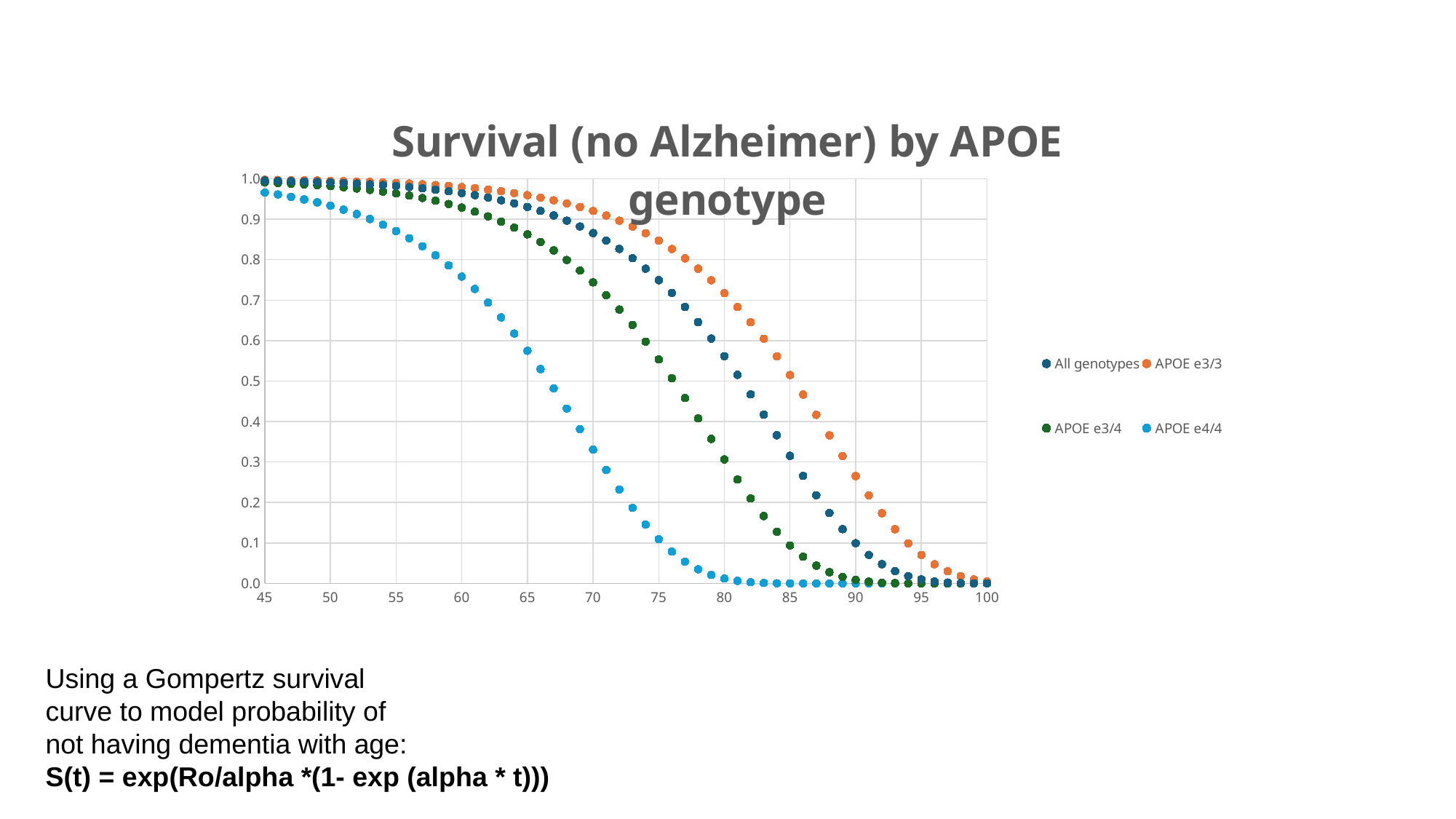
Is the value for All genotypes at age 85 greater or less than 0.5? less At age 75, which series has the higher value, All genotypes or APOE e3/4? All genotypes Do the survival values rise or fall as age increases along the x axis? Fall Is the value for APOE e3/3 at age 80 greater or less than 0.6? greater Is the value for APOE e3/4 at age 75 greater or less than 0.5? greater How many series does the legend list? 4 Which series is plotted in orange? APOE e3/3 What kind of chart is shown on the slide? Scatter chart What is the title of the chart? Survival (no Alzheimer) by APOE genotype At age 80, which series has the higher value, APOE e3/3 or APOE e4/4? APOE e3/3